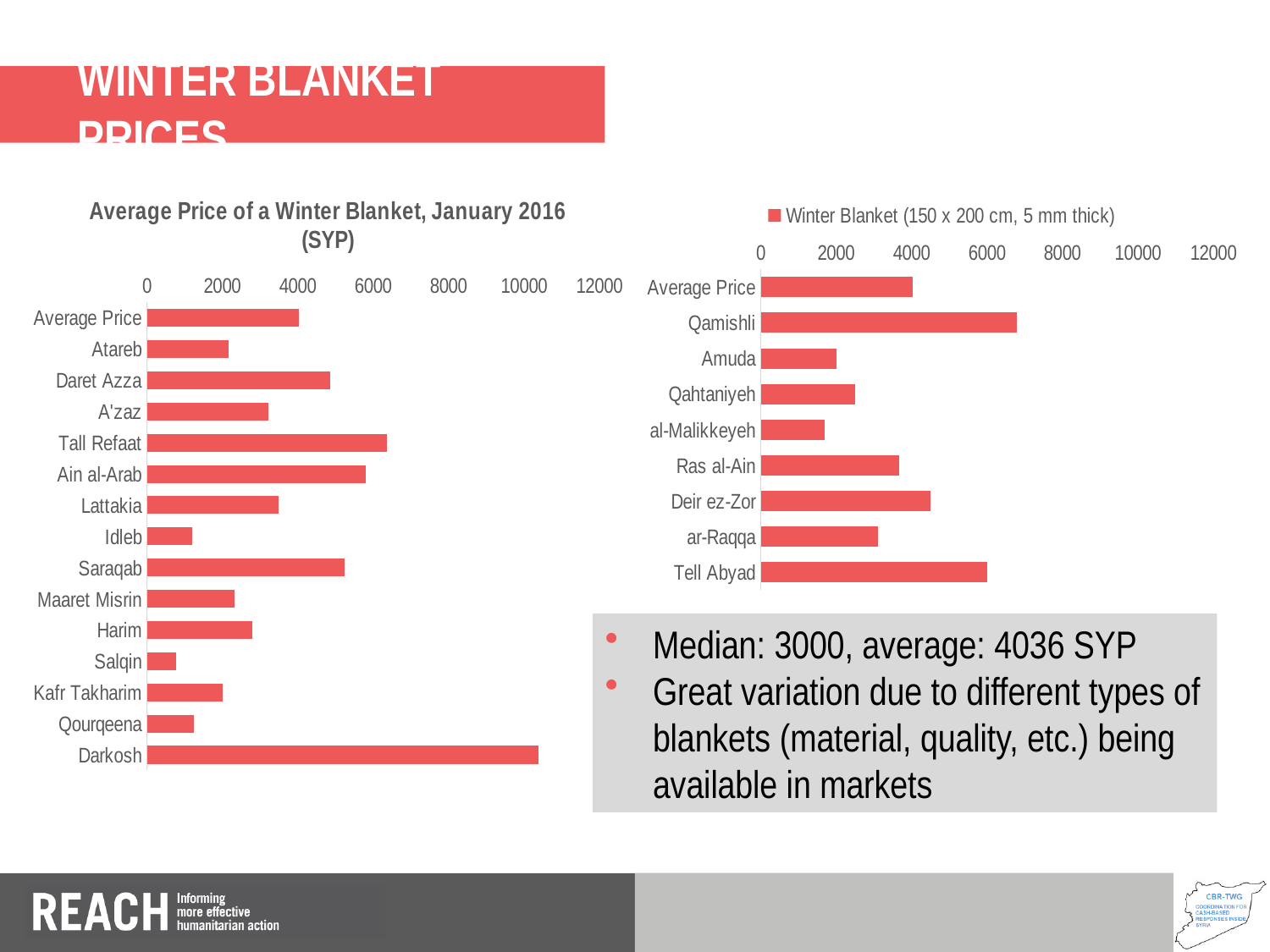
What is the legend entry shown for the chart on the right of the slide? Winter Blanket (150 x 200 cm, 5 mm thick) In the chart titled 'Average Price of a Winter Blanket, January 2016 (SYP)', which is larger, the value for Tall Refaat or the value for Ain al-Arab? Tall Refaat How many bars are plotted in the chart on the right of the slide? 9 In the chart on the right of the slide, which location has the lowest value? al-Malikkeyeh In the chart titled 'Average Price of a Winter Blanket, January 2016 (SYP)', which location has the lowest price? Salqin In the chart titled 'Average Price of a Winter Blanket, January 2016 (SYP)', is the value for Idleb greater or less than 2000? less What kind of chart is the chart titled 'Average Price of a Winter Blanket, January 2016 (SYP)'? bar chart How many bars are plotted in the chart titled 'Average Price of a Winter Blanket, January 2016 (SYP)'? 15 In the chart titled 'Average Price of a Winter Blanket, January 2016 (SYP)', which location has the highest price? Darkosh In the chart on the right of the slide, which location has the highest value? Qamishli In the chart on the right of the slide, is the value for Tell Abyad greater or less than 4000? greater In the chart titled 'Average Price of a Winter Blanket, January 2016 (SYP)', is the value for Darkosh greater or less than 10000? greater